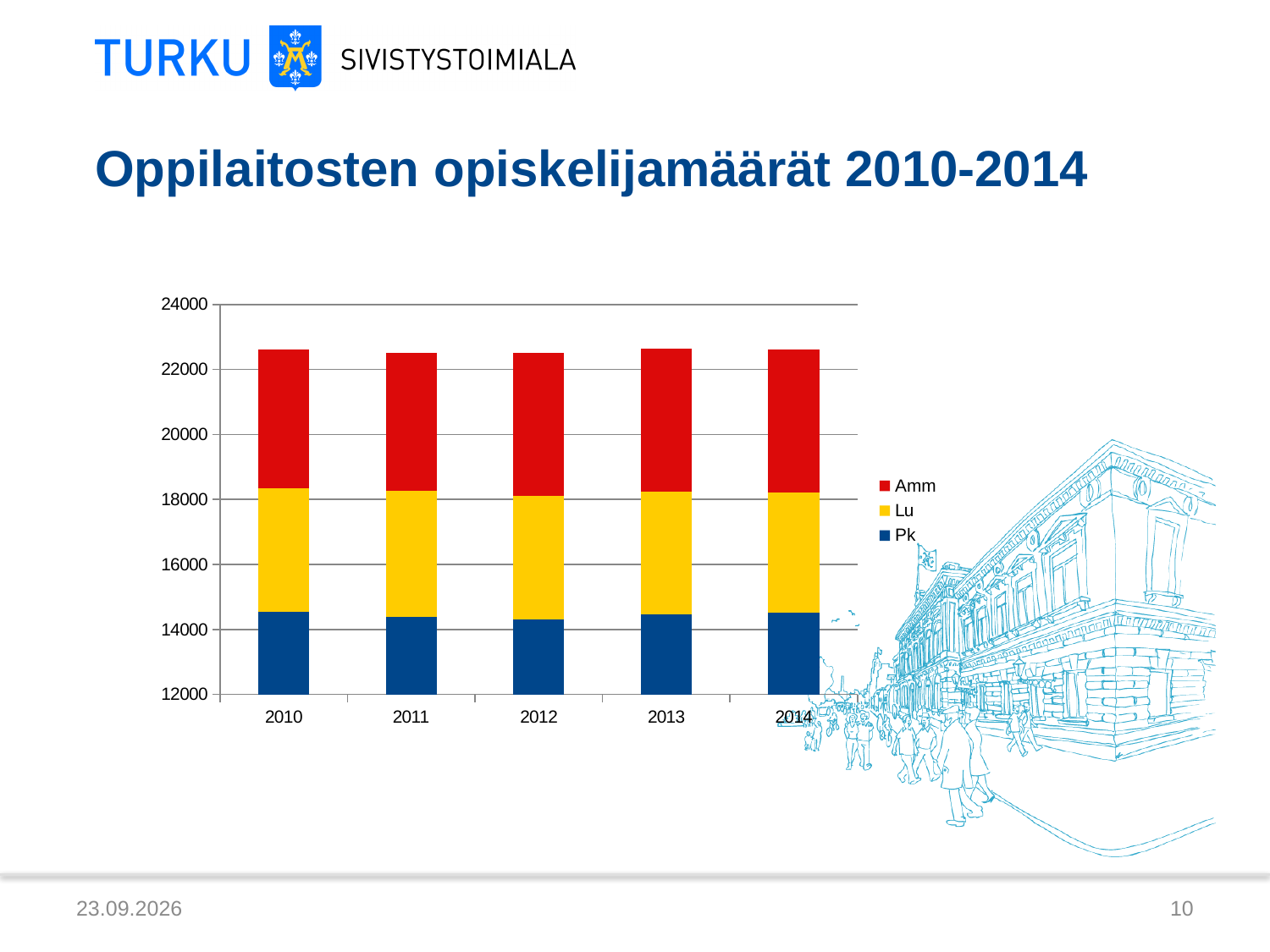
Is the top of the Pk segment for 2010 greater or less than 14000? greater How many series does the chart legend list? 3 What is the first year shown on the x axis of the chart? 2010 How many years are shown on the x axis of the chart? 5 Which series is shown in dark blue at the bottom of each stacked bar? Pk Which series is shown in red in the chart? Amm Is the total height of the stacked bar for 2013 greater or less than 24000? less Is the top of the Lu segment for 2014 greater or less than 16000? greater What kind of chart is shown on the slide? stacked bar chart